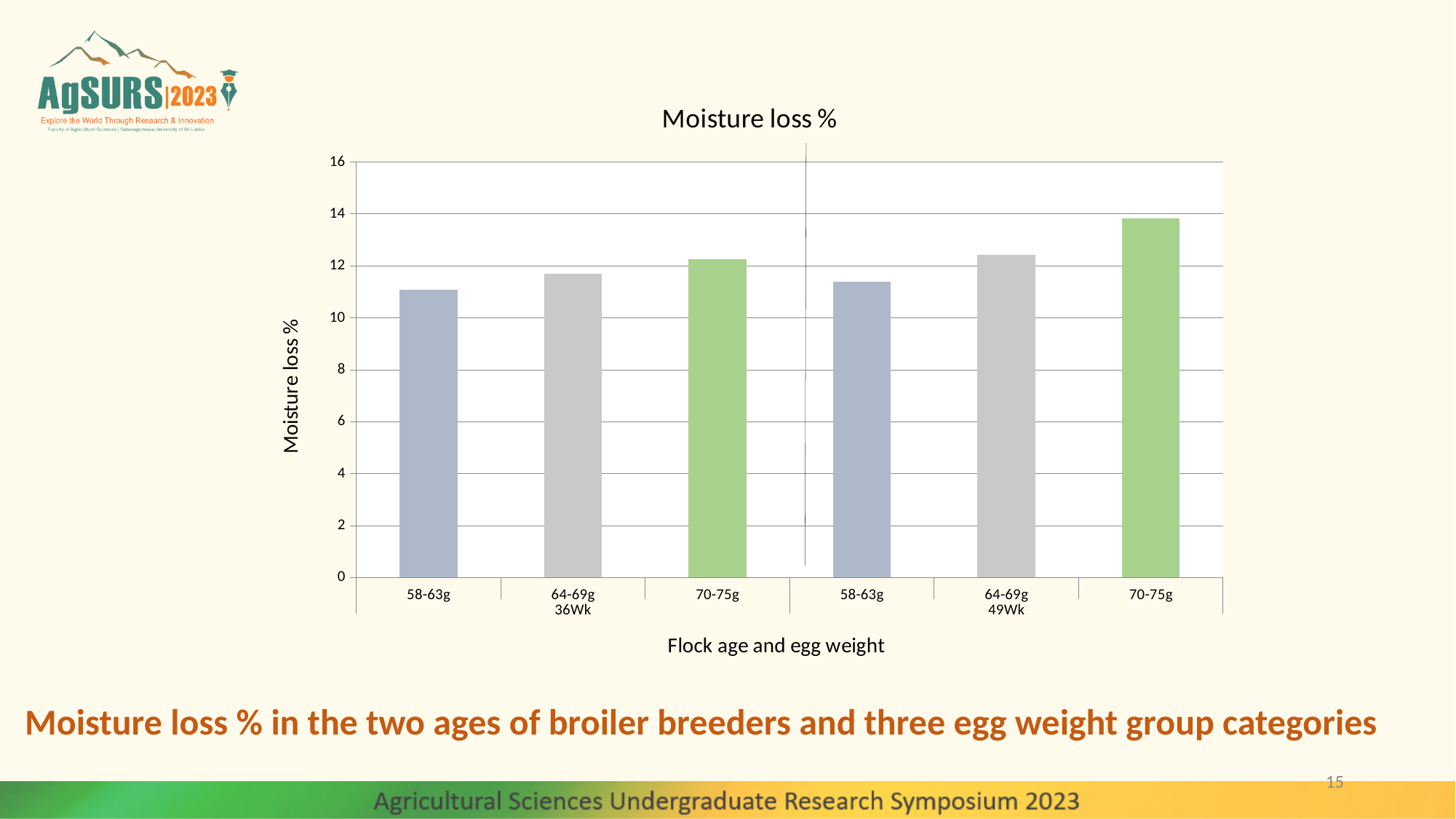
Within the 49Wk group, does moisture loss % rise or fall as egg weight increases from 58-63g to 70-75g? rise Which has a higher moisture loss %: 70-75g at 36Wk or 70-75g at 49Wk? 70-75g at 49Wk Which has a higher moisture loss %: 58-63g at 49Wk or 64-69g at 49Wk? 64-69g at 49Wk Is the moisture loss % for 58-63g at 36Wk greater or less than 12? less What kind of chart is shown on the slide? bar chart Which bar has the lowest moisture loss %? 58-63g at 36Wk Is the moisture loss % for 64-69g at 49Wk greater or less than 14? less What is the title of the chart? Moisture loss % Is the moisture loss % for 70-75g at 49Wk greater or less than 12? greater How many bars are plotted in the chart? 6 Which bar has the highest moisture loss %? 70-75g at 49Wk What is the label of the x axis? Flock age and egg weight